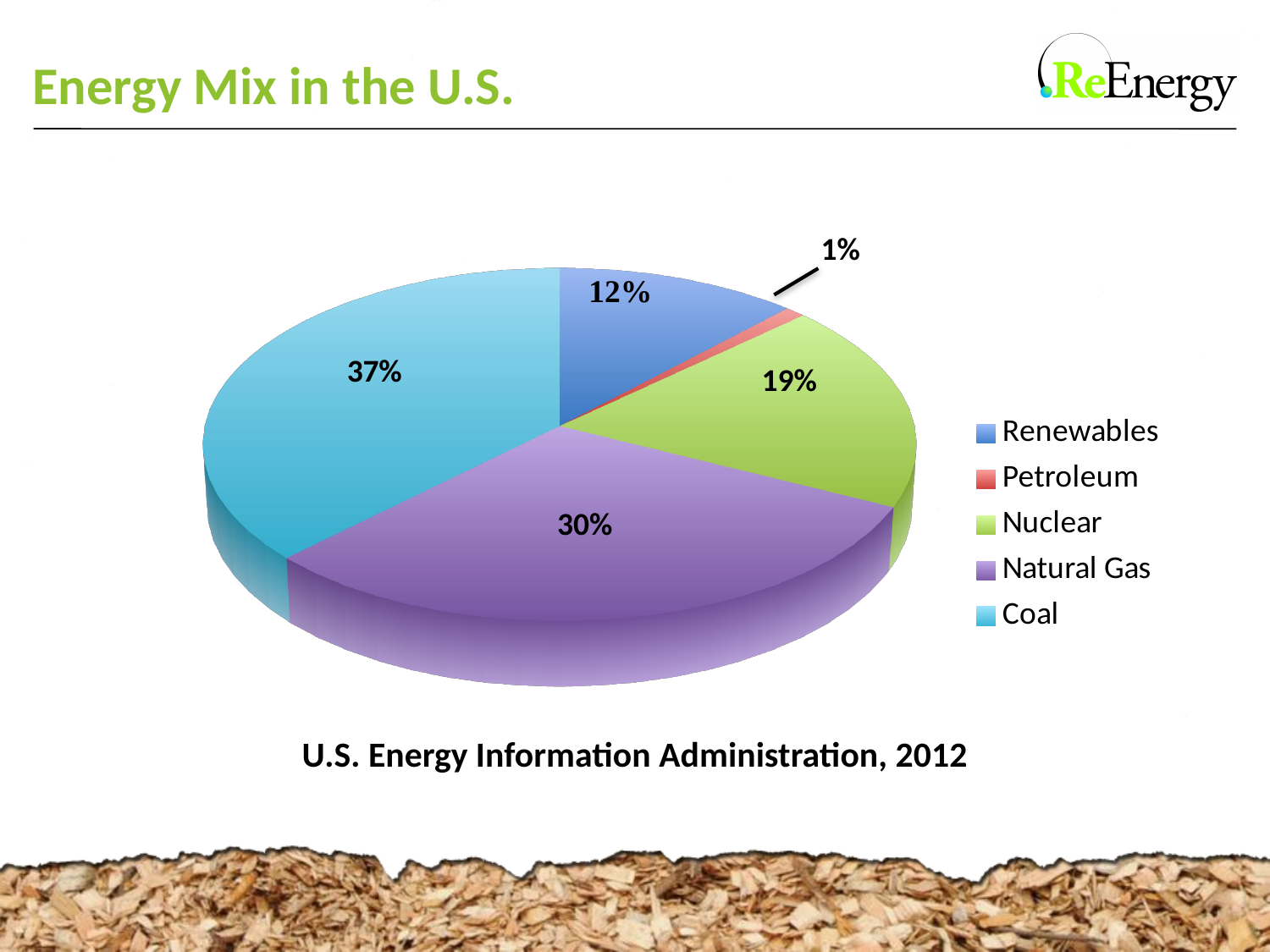
Which energy source has the smallest share of the pie? Petroleum What share of the U.S. energy mix does Coal account for? 37% How many energy sources are shown in the pie chart? 5 Which energy source has the largest share of the pie? Coal What source is cited below the chart? U.S. Energy Information Administration, 2012 What kind of chart is shown on the slide? Pie chart What share of the U.S. energy mix does Nuclear account for? 19% How many percentage points larger is the Coal share than the Natural Gas share? 7 Which has a larger share, Nuclear or Renewables? Nuclear What share of the U.S. energy mix does Renewables account for? 12% What share of the U.S. energy mix does Natural Gas account for? 30% What share of the U.S. energy mix does Petroleum account for? 1%